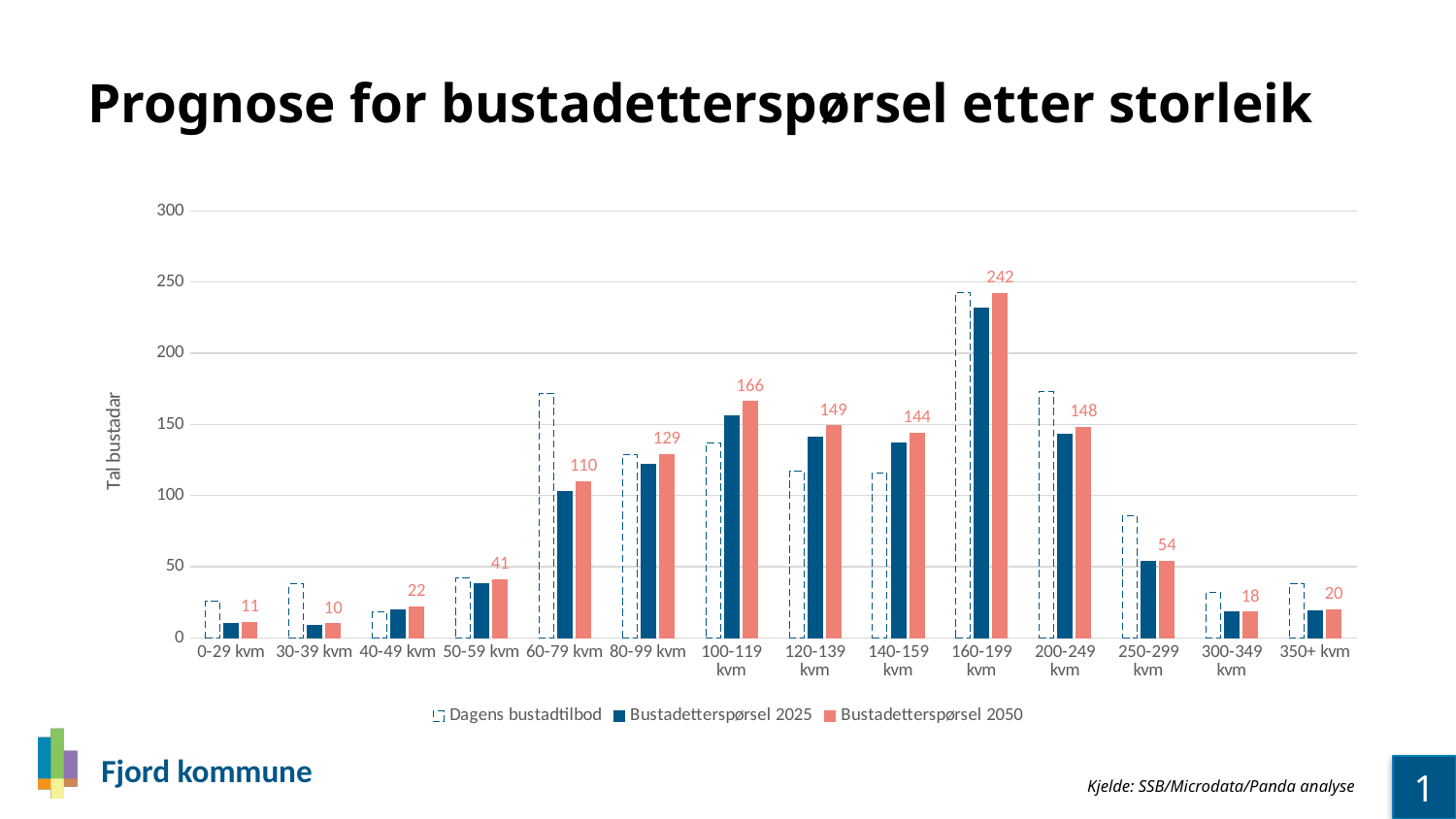
How many series does the legend list? 3 How many size categories are shown on the x axis? 14 What is the difference between the Bustadetterspørsel 2050 values for 100-119 kvm and 120-139 kvm? 17 Is the Bustadetterspørsel 2025 value for 160-199 kvm greater or less than 200? greater What is the Bustadetterspørsel 2050 value for the 160-199 kvm category? 242 What kind of chart is shown on the slide? bar chart Which category has the lowest Bustadetterspørsel 2050 value? 30-39 kvm What is the Bustadetterspørsel 2050 value for the 100-119 kvm category? 166 Is the Dagens bustadtilbod value for 60-79 kvm greater or less than 150? greater What is the difference between the Bustadetterspørsel 2050 values for 160-199 kvm and 200-249 kvm? 94 Which category has the larger Bustadetterspørsel 2050 value, 120-139 kvm or 140-159 kvm? 120-139 kvm Which category has the highest Bustadetterspørsel 2050 value? 160-199 kvm